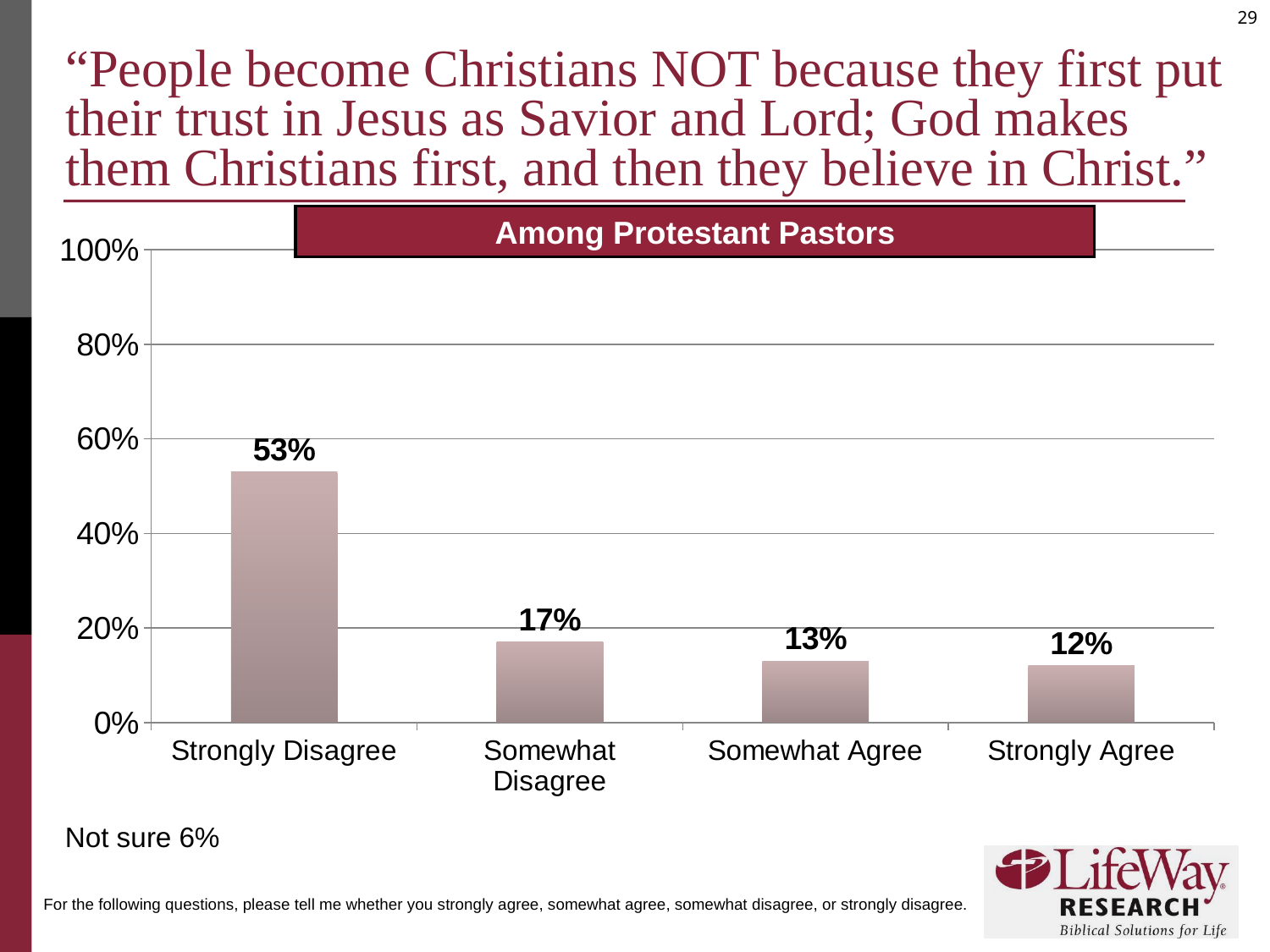
What percentage of Protestant pastors strongly disagree with the statement? 53% What group does the chart's label say the results are among? Protestant Pastors What is the value shown for Somewhat Agree? 13% Which response category has the lowest value? Strongly Agree Which is larger, the value for Somewhat Disagree or the value for Somewhat Agree? Somewhat Disagree Which response category has the highest value? Strongly Disagree Is the value for Strongly Disagree greater or less than 40%? greater What is the value shown for Strongly Agree? 12% What is the value shown for Somewhat Disagree? 17% What is the difference between the Strongly Disagree and Somewhat Disagree values? 36% What kind of chart is shown on the slide? Bar chart How many response categories are shown on the x axis? 4